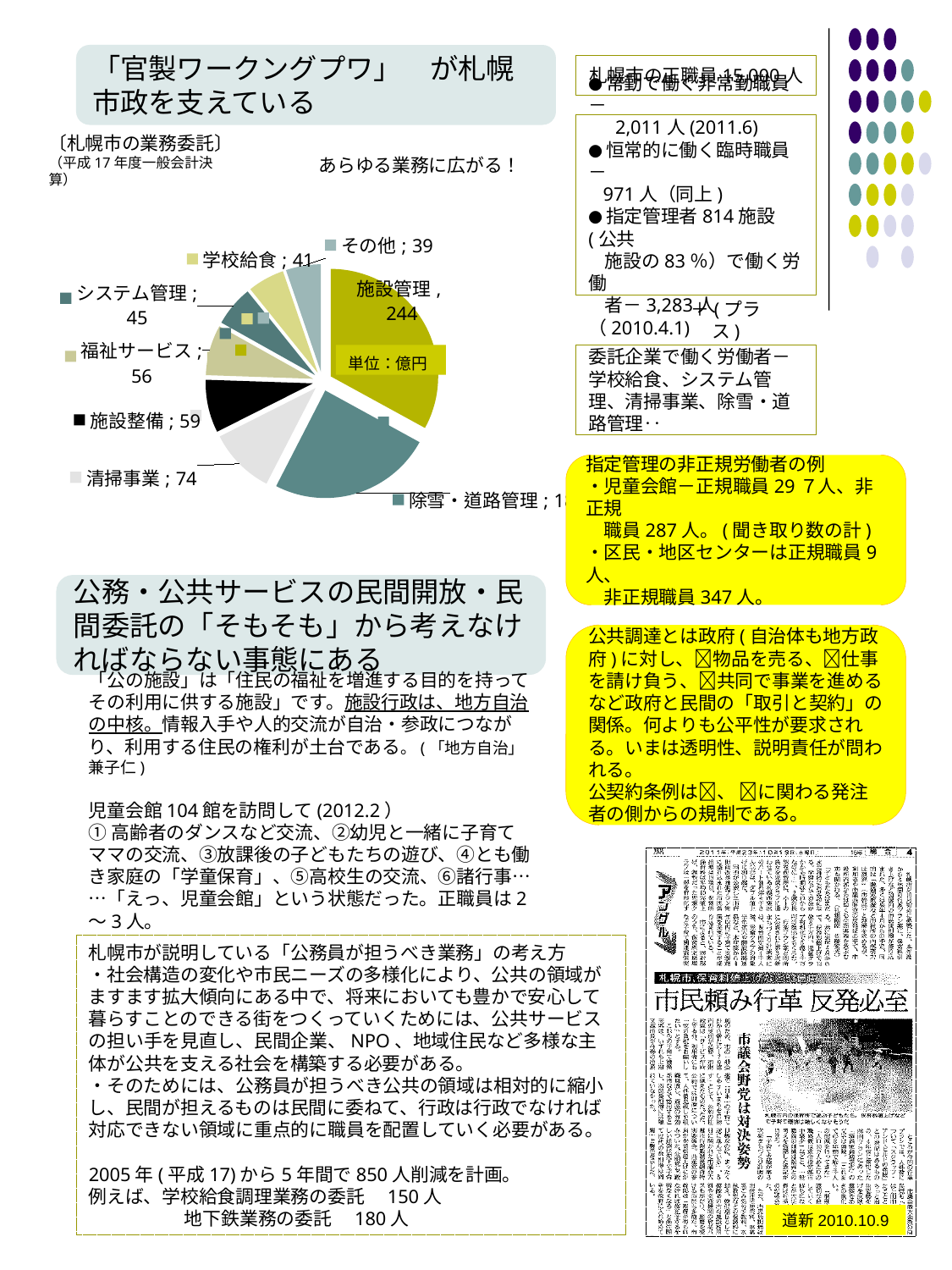
What unit is shown for the values in the pie chart? 億円 What is the difference between the values for 施設管理 and 清掃事業? 170 What is the value for 施設整備 in the pie chart? 59 Which category has the largest slice in the pie chart? 施設管理 What is the value for 施設管理 in the pie chart? 244 What is the value for 清掃事業 in the pie chart? 74 What is the value for 福祉サービス in the pie chart? 56 What is the value for 学校給食 in the pie chart? 41 Which category has the smallest slice in the pie chart? その他 What is the value for システム管理 in the pie chart? 45 Which is larger, the value for 施設整備 or the value for 学校給食? 施設整備 What kind of chart is shown on the slide? pie chart